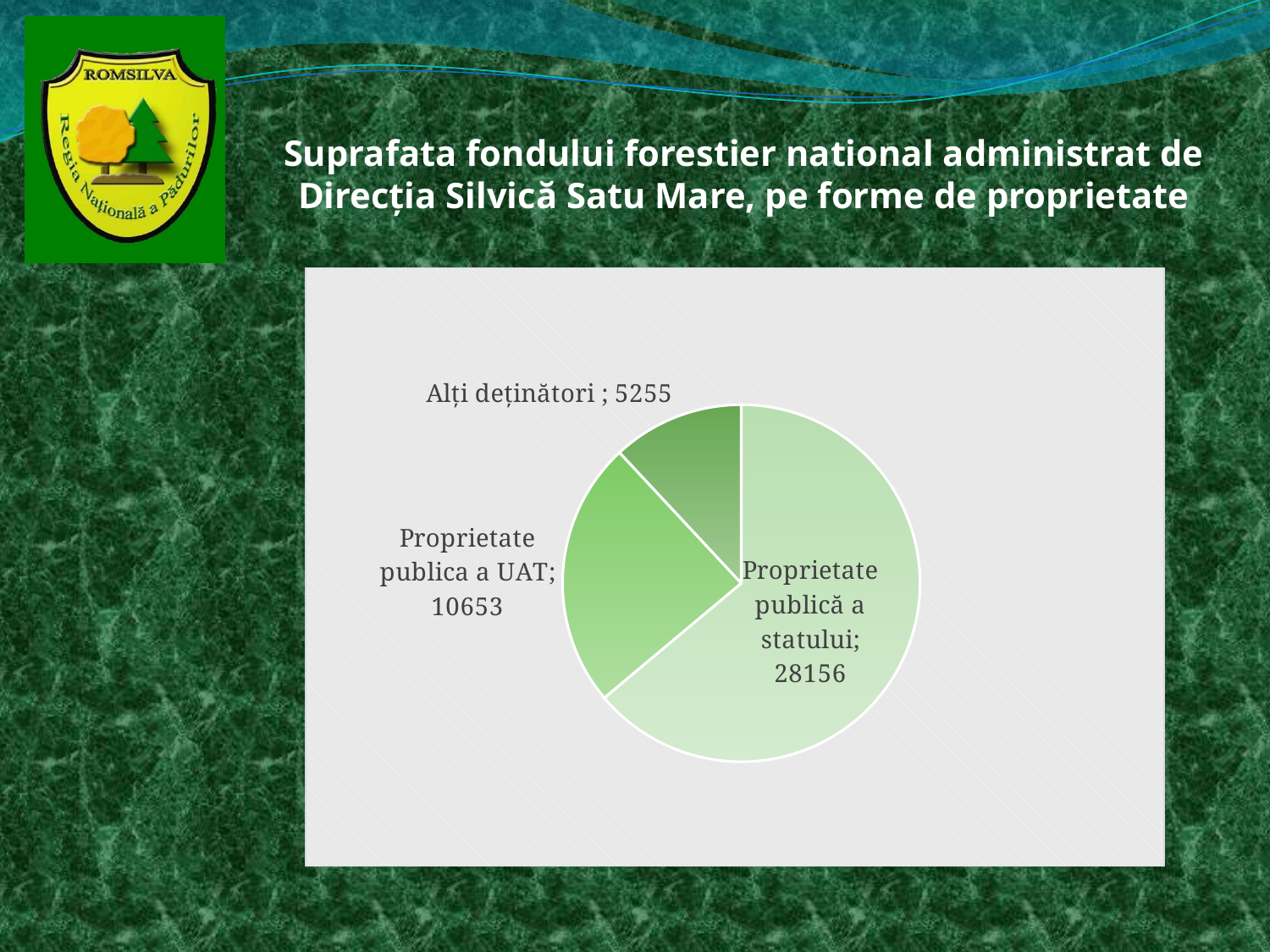
What is the value for Alți deținători? 5255 What is the difference between the values for Proprietate publica a UAT and Alți deținători? 5398 Which category has the smallest slice of the pie? Alți deținători How many slices does the pie chart have? 3 What is the value for Proprietate publica a UAT? 10653 What is the value for Proprietate publică a statului? 28156 Which category has the largest slice of the pie? Proprietate publică a statului Which is larger, the value for Proprietate publica a UAT or the value for Alți deținători? Proprietate publica a UAT What is the difference between the values for Proprietate publică a statului and Proprietate publica a UAT? 17503 What is the title of the slide containing the pie chart? Suprafata fondului forestier national administrat de Direcția Silvică Satu Mare, pe forme de proprietate What kind of chart is shown on the slide? pie chart What is the total of all three slices in the pie chart? 44064